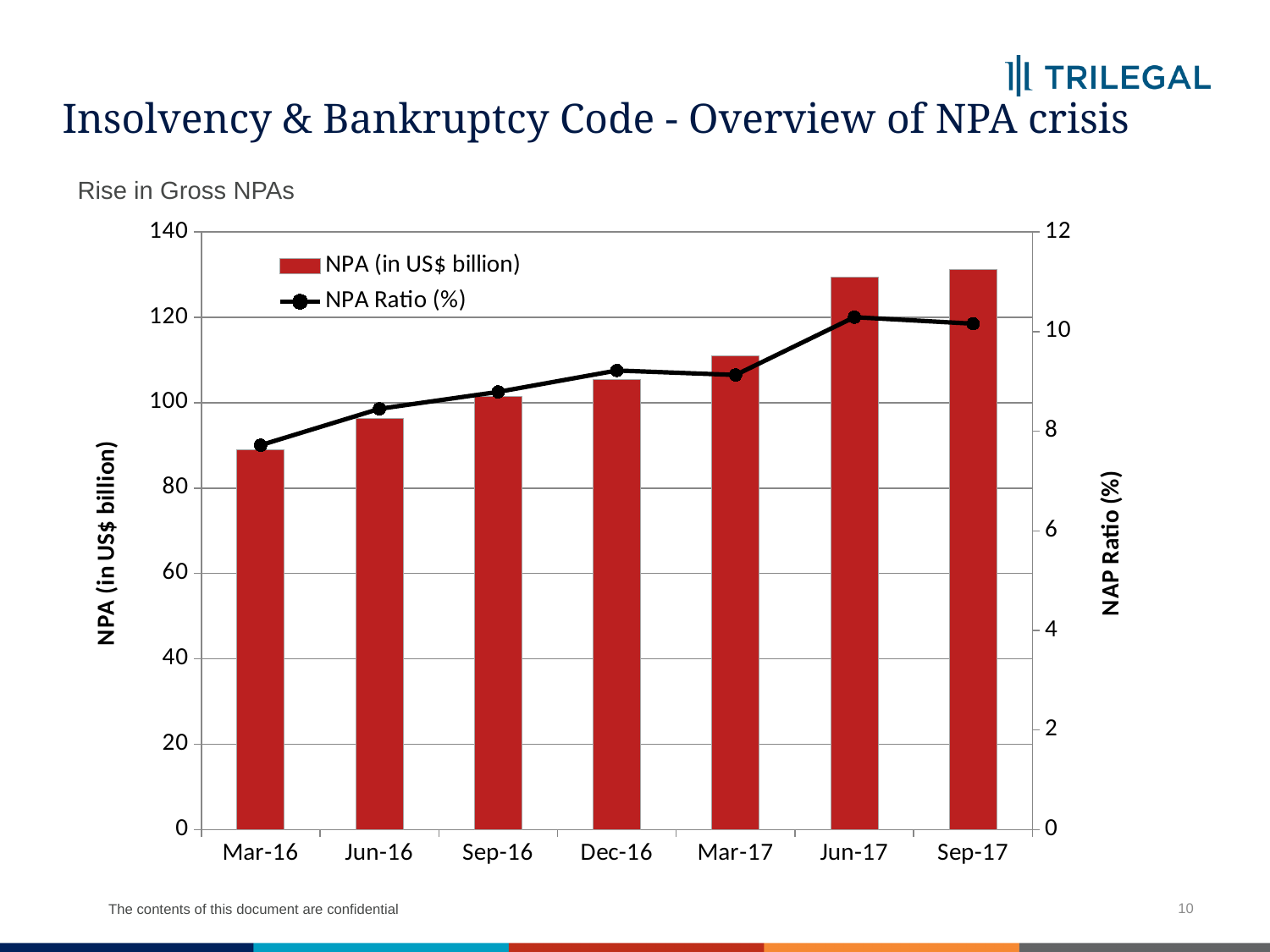
Which is larger, the NPA (in US$ billion) for Mar-17 or for Jun-17? Jun-17 Is the NPA (in US$ billion) for Dec-16 greater or less than 100? greater Which period has the lowest NPA (in US$ billion)? Mar-16 What is the title shown above the chart? Rise in Gross NPAs Is the NPA Ratio (%) for Mar-17 greater or less than 10? less How many series does the chart legend list? 2 What kind of chart is shown on the slide? A combined bar and line chart Is the NPA (in US$ billion) for Mar-16 greater or less than 100? less Does the NPA (in US$ billion) generally rise or fall from Mar-16 to Sep-17? rise Which period has the lowest NPA Ratio (%)? Mar-16 How many time periods are shown on the x axis of the chart? 7